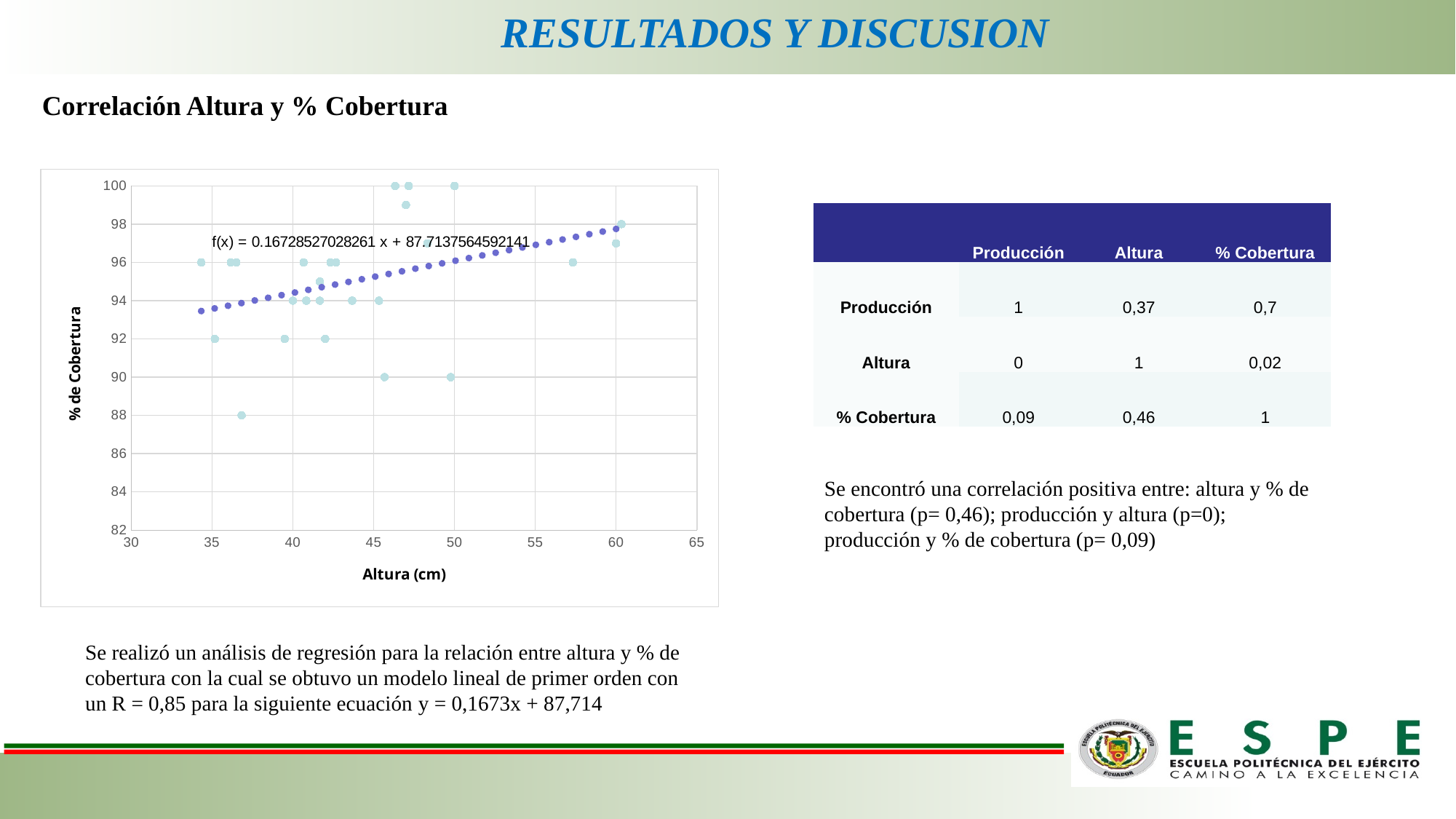
What is the title of the x axis of the chart? Altura (cm) What is the highest % de Cobertura value plotted on the chart? 100 Is the trendline value at an Altura of 35 cm greater or less than 96 % de Cobertura? less What kind of chart is shown on the slide? scatter chart Is the trendline value at an Altura of 60 cm greater or less than 96 % de Cobertura? greater Is the lowest plotted point on the chart greater or less than 90 % de Cobertura? less What is the title of the y axis of the chart? % de Cobertura Does the trendline on the chart rise or fall as Altura (cm) increases? rises What is the lowest % de Cobertura value plotted on the chart? 88